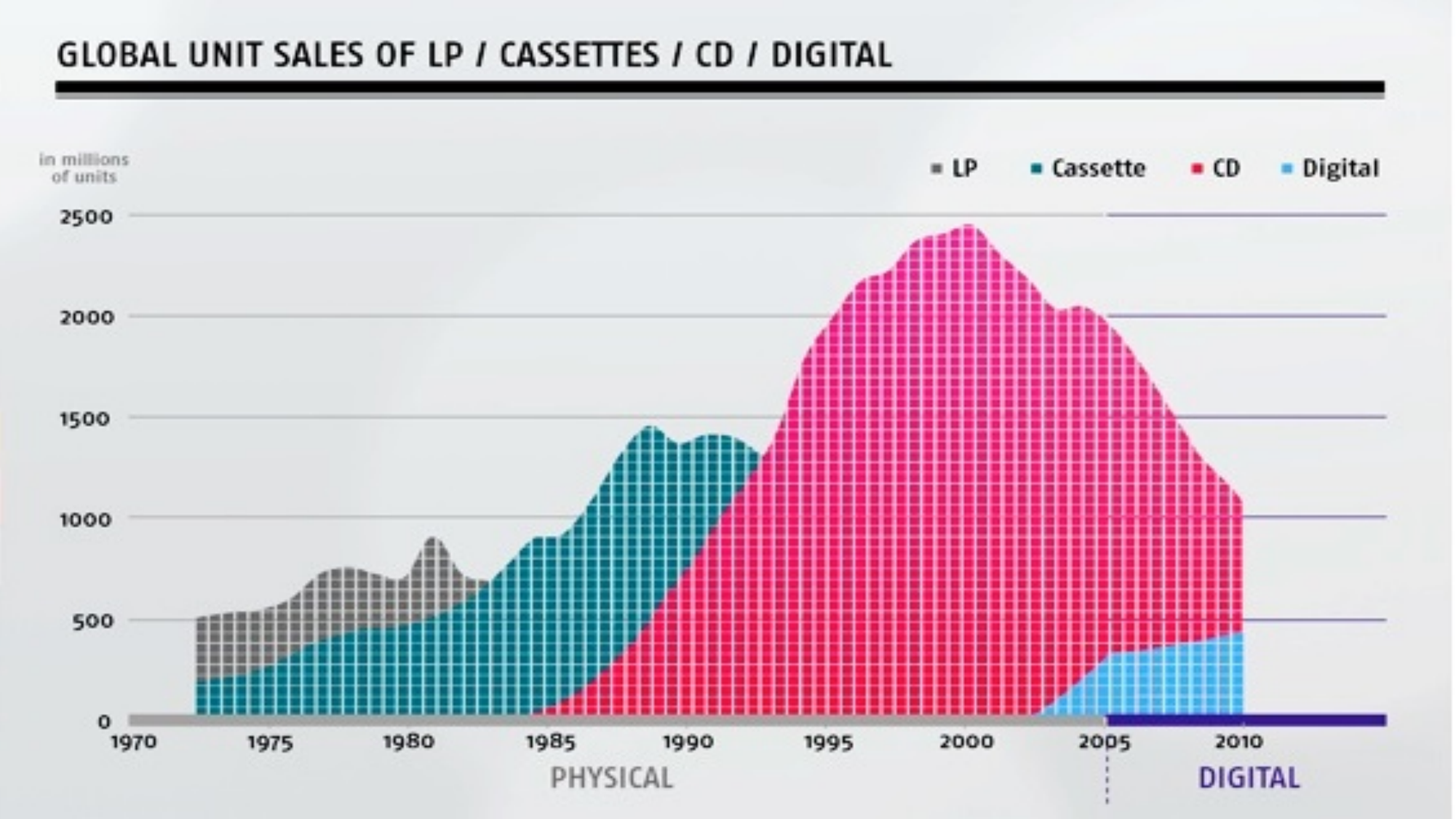
How many series does the legend list? 4 Do total unit sales rise or fall between 2000 and 2010? fall Is the total unit sales value in 1990 greater or less than 1000? greater What is the title of the chart? GLOBAL UNIT SALES OF LP / CASSETTES / CD / DIGITAL Is the total unit sales value in 2010 greater or less than 1500? less Is the total unit sales value in 1980 greater or less than 1000? less What kind of chart is shown on the slide? Area chart In what units are the values on the y axis expressed? in millions of units Which series accounts for the largest share of unit sales in 2000? CD Which series accounts for the largest share of unit sales in 1975? LP